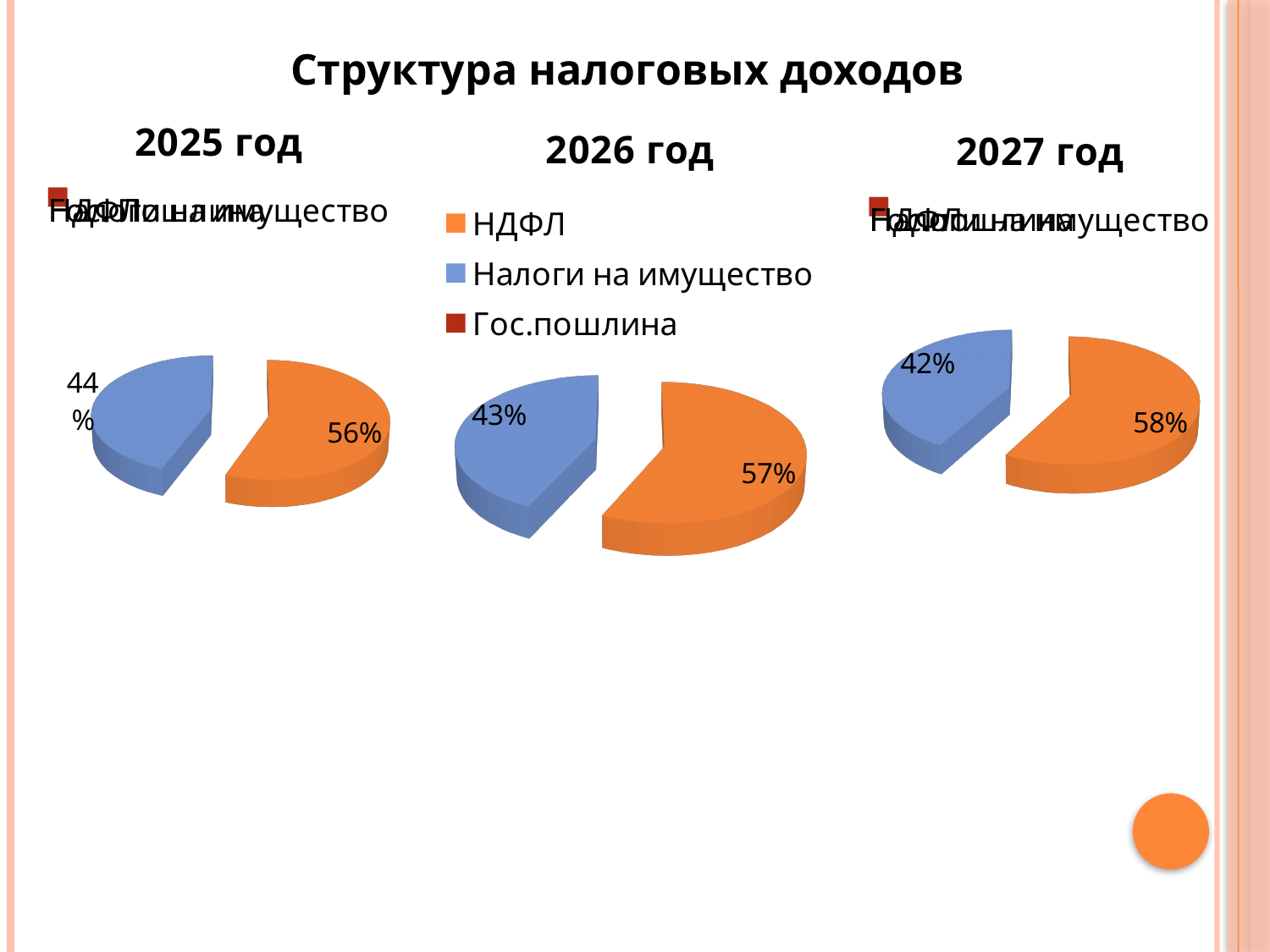
In the 2026 год chart, what share does НДФЛ have? 57% In the 2025 год chart, what share does Налоги на имущество have? 44% How many entries does the legend of the 2026 год chart list? 3 In the 2025 год chart, what is the difference between the НДФЛ share and the Налоги на имущество share? 12% In the 2026 год chart, what share does Налоги на имущество have? 43% In the 2027 год chart, what share does НДФЛ have? 58% In the 2026 год chart, which is larger: НДФЛ or Налоги на имущество? НДФЛ In the 2027 год chart, which category has the largest slice? НДФЛ What kind of chart is used for the 2026 год chart? pie chart In the 2027 год chart, what share does Налоги на имущество have? 42% In the 2026 год chart, which colour represents НДФЛ? orange In the 2025 год chart, what share does НДФЛ have? 56%